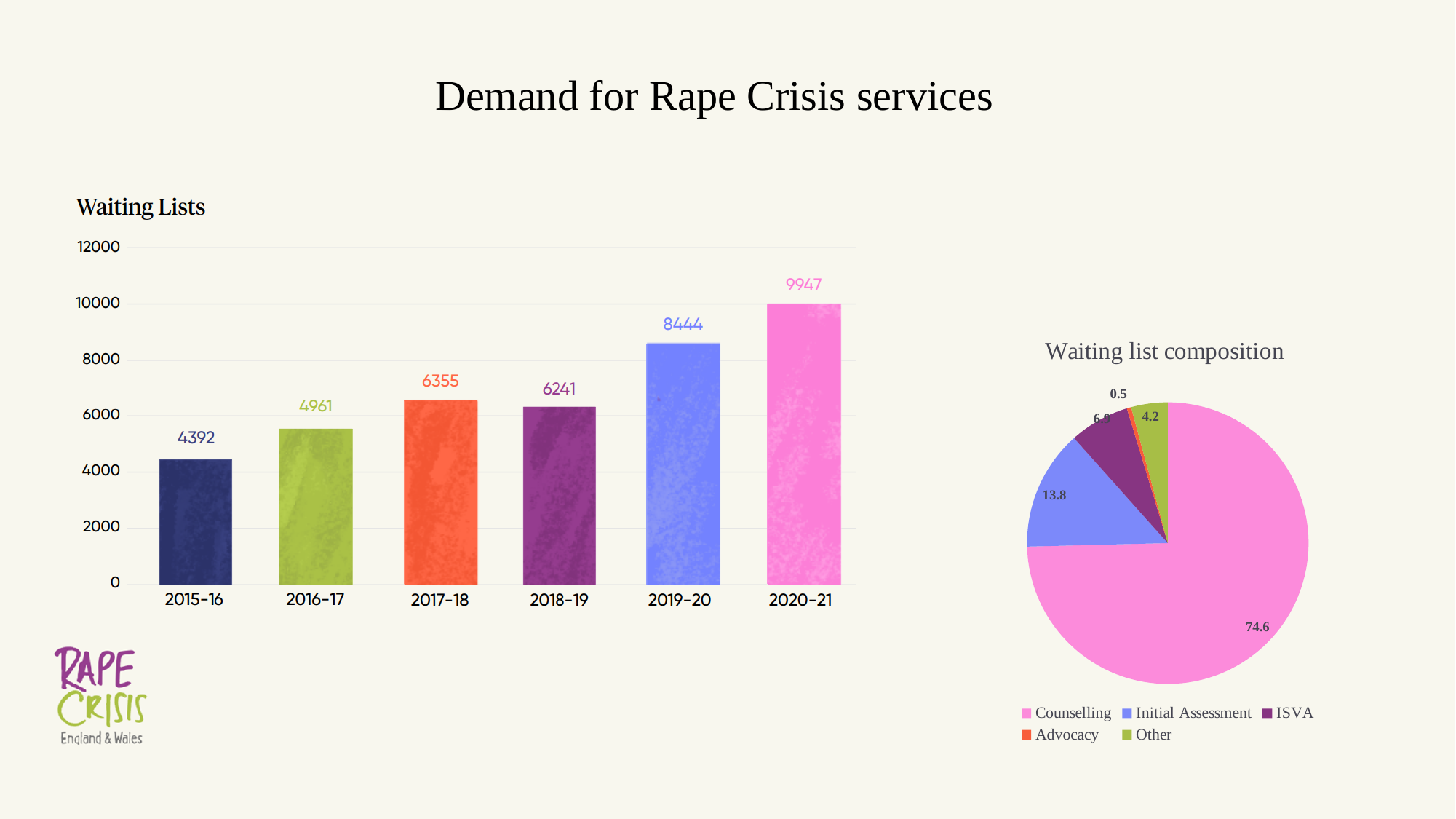
How many years are shown in the Waiting Lists chart? 6 How many categories does the legend of the Waiting list composition chart list? 5 In the Waiting Lists chart, what is the difference between the values for 2020-21 and 2019-20? 1503 What kind of chart is the Waiting Lists chart? Bar chart In the Waiting list composition chart, what is the value for Initial Assessment? 13.8 In the Waiting Lists chart, which year has the lowest value? 2015-16 In the Waiting Lists chart, which year has the highest value? 2020-21 In the Waiting Lists chart, what is the value for 2018-19? 6241 In the Waiting Lists chart, what is the value for 2020-21? 9947 In the Waiting Lists chart, which is larger, the value for 2017-18 or 2018-19? 2017-18 In the Waiting Lists chart, what is the value for 2015-16? 4392 In the Waiting list composition chart, what is the value for Counselling? 74.6